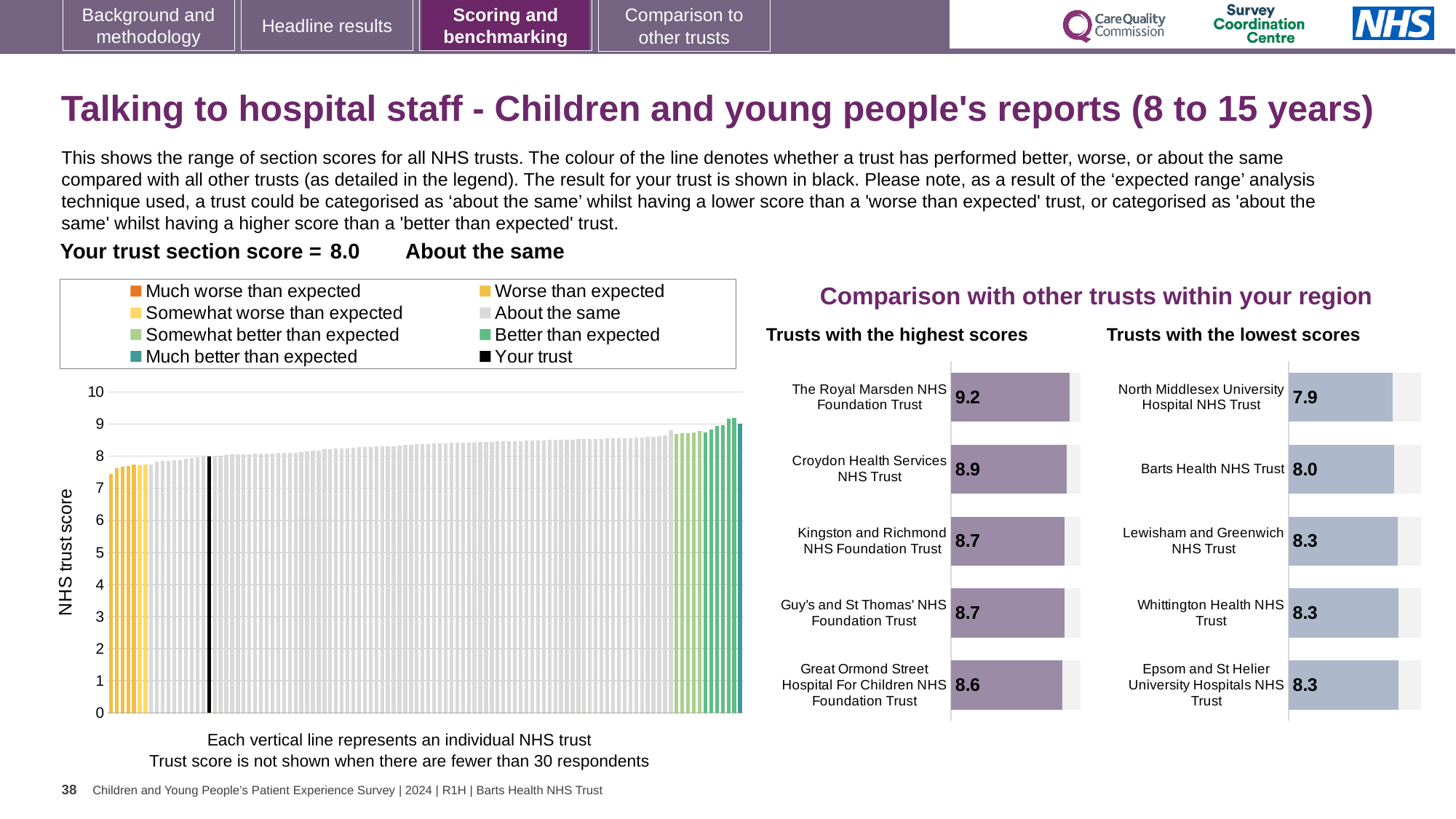
In the 'Trusts with the lowest scores' chart, which trust has the lowest score? North Middlesex University Hospital NHS Trust How many entries does the legend of the main 'NHS trust score' bar chart list? 8 How many trusts are shown in the 'Trusts with the highest scores' chart? 5 In the 'Trusts with the highest scores' chart, what is the difference between the scores of The Royal Marsden NHS Foundation Trust and Croydon Health Services NHS Trust? 0.3 In the 'Trusts with the lowest scores' chart, which has the higher score: Barts Health NHS Trust or Lewisham and Greenwich NHS Trust? Lewisham and Greenwich NHS Trust In the main 'NHS trust score' chart, is the value of the black 'Your trust' bar greater or less than 5? greater In the 'Trusts with the highest scores' chart, which trust has the highest score? The Royal Marsden NHS Foundation Trust In the 'Trusts with the highest scores' chart, what is the score for The Royal Marsden NHS Foundation Trust? 9.2 In the 'Trusts with the highest scores' chart, what is the score for Great Ormond Street Hospital For Children NHS Foundation Trust? 8.6 In the 'Trusts with the lowest scores' chart, what is the score for North Middlesex University Hospital NHS Trust? 7.9 In the 'Trusts with the lowest scores' chart, what is the score for Barts Health NHS Trust? 8.0 What kind of chart is the main chart on the left showing NHS trust scores? bar chart